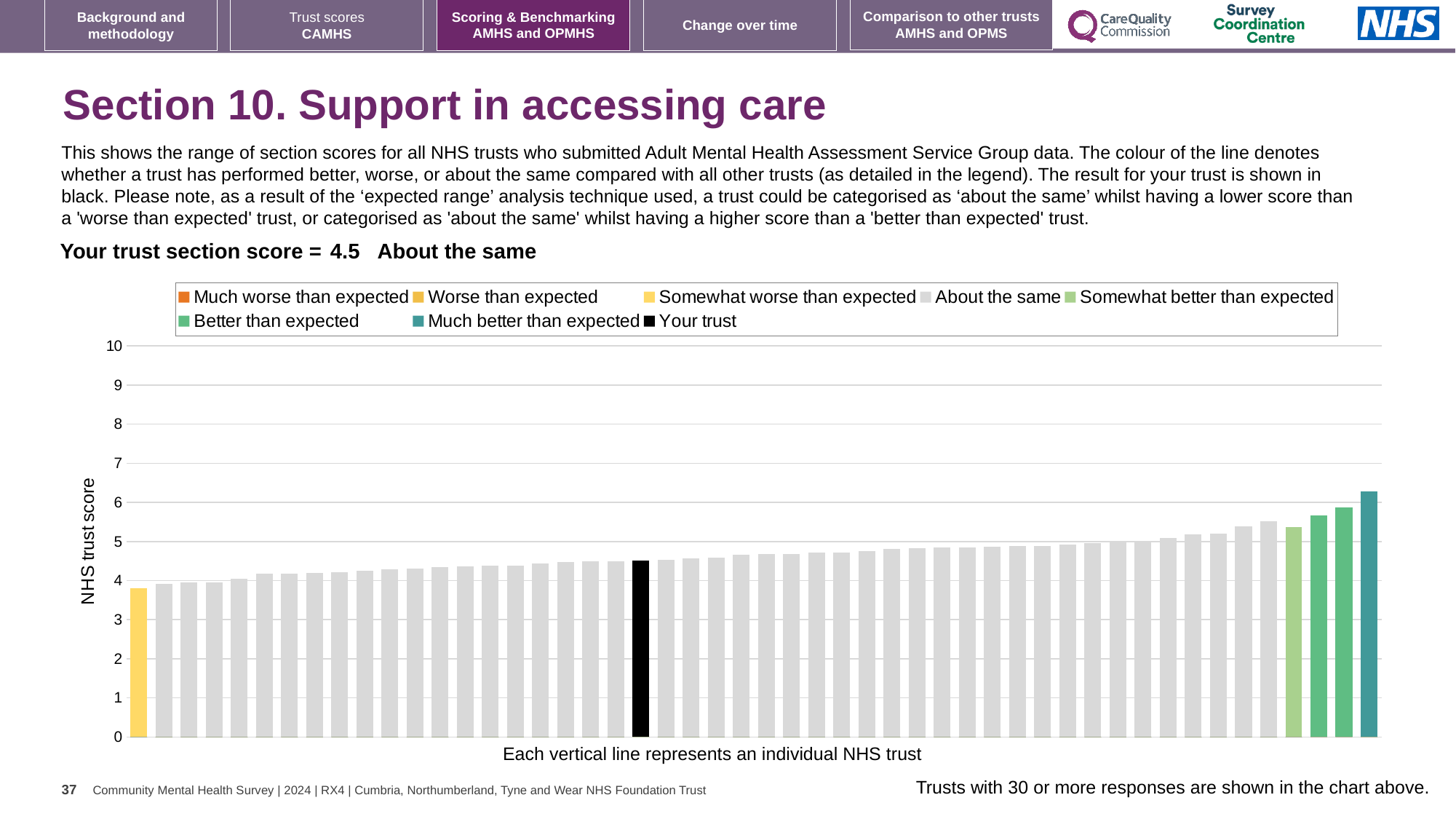
How many entries does the chart legend list? 8 What is your trust's section score for Section 10, Support in accessing care? 4.5 Which legend category does your trust fall into? About the same How many trusts are shown in the 'better than expected' (green) category? 2 What colour is the bar representing your trust? Black What kind of chart is shown on the slide? Bar chart Which legend category has the lowest-scoring trust in the chart? Somewhat worse than expected Is the value for your trust greater or less than 5? less Do the bar values rise or fall from left to right along the x axis? Rise Is the value for the highest bar (much better than expected) greater or less than 6? greater Which is higher, the bar for your trust or the teal 'much better than expected' bar? Much better than expected